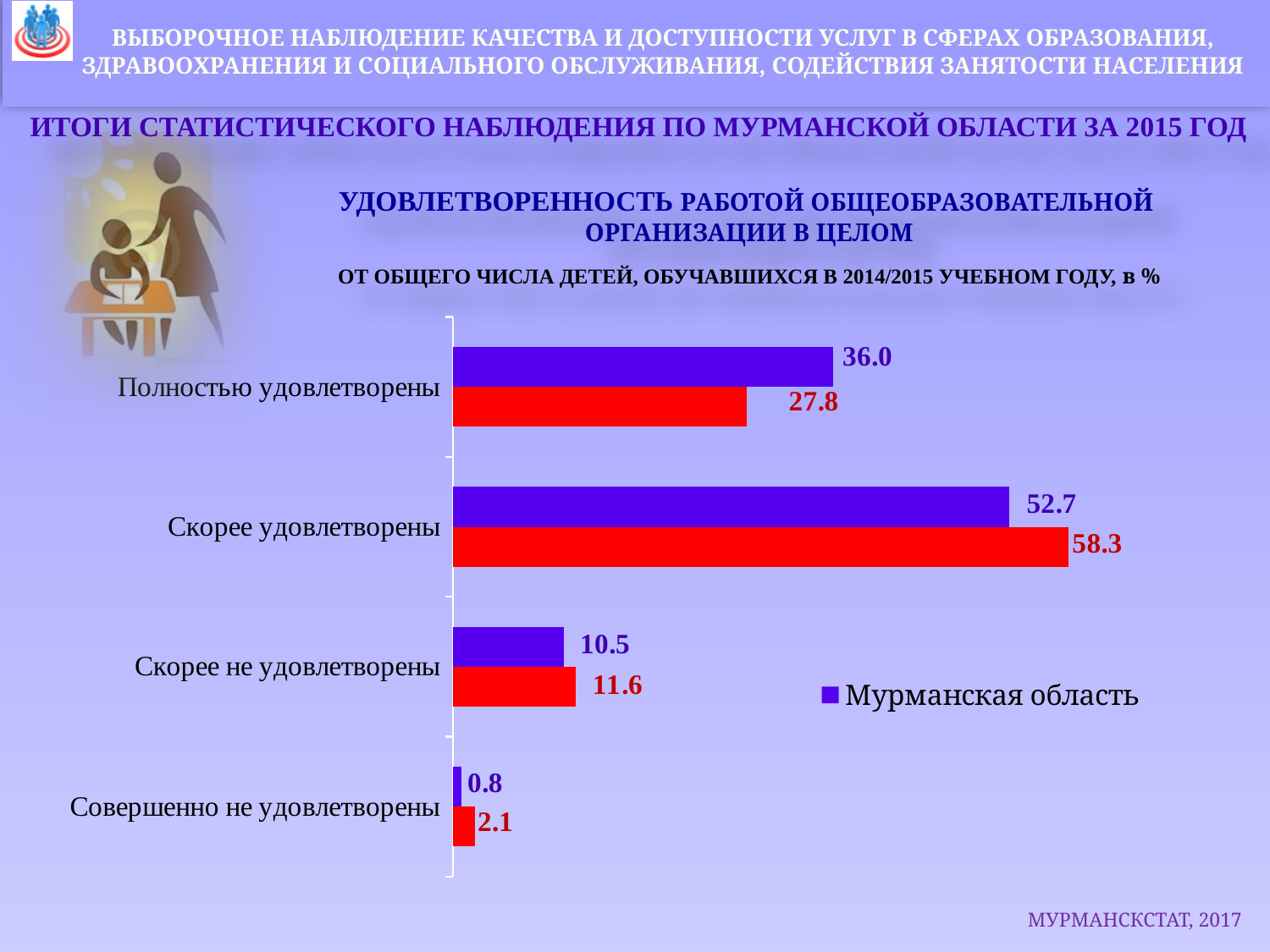
Which category has the highest value for Мурманская область? Скорее удовлетворены Which category has the lowest value of the red bars? Совершенно не удовлетворены What is the value for Мурманская область in the category 'Совершенно не удовлетворены'? 0.8 How many categories are shown on the chart? 4 What is the value of the red bar in the category 'Скорее не удовлетворены'? 11.6 What is the difference between the Мурманская область value and the red bar value in the category 'Полностью удовлетворены'? 8.2 What is the value of the red bar in the category 'Скорее удовлетворены'? 58.3 What kind of chart is shown on the slide? bar chart What series name is shown in the chart legend? Мурманская область In the category 'Скорее удовлетворены', which is larger: the Мурманская область value or the red bar value? the red bar value (58.3) What is the value for Мурманская область in the category 'Полностью удовлетворены'? 36.0 How many series does the legend list? 1